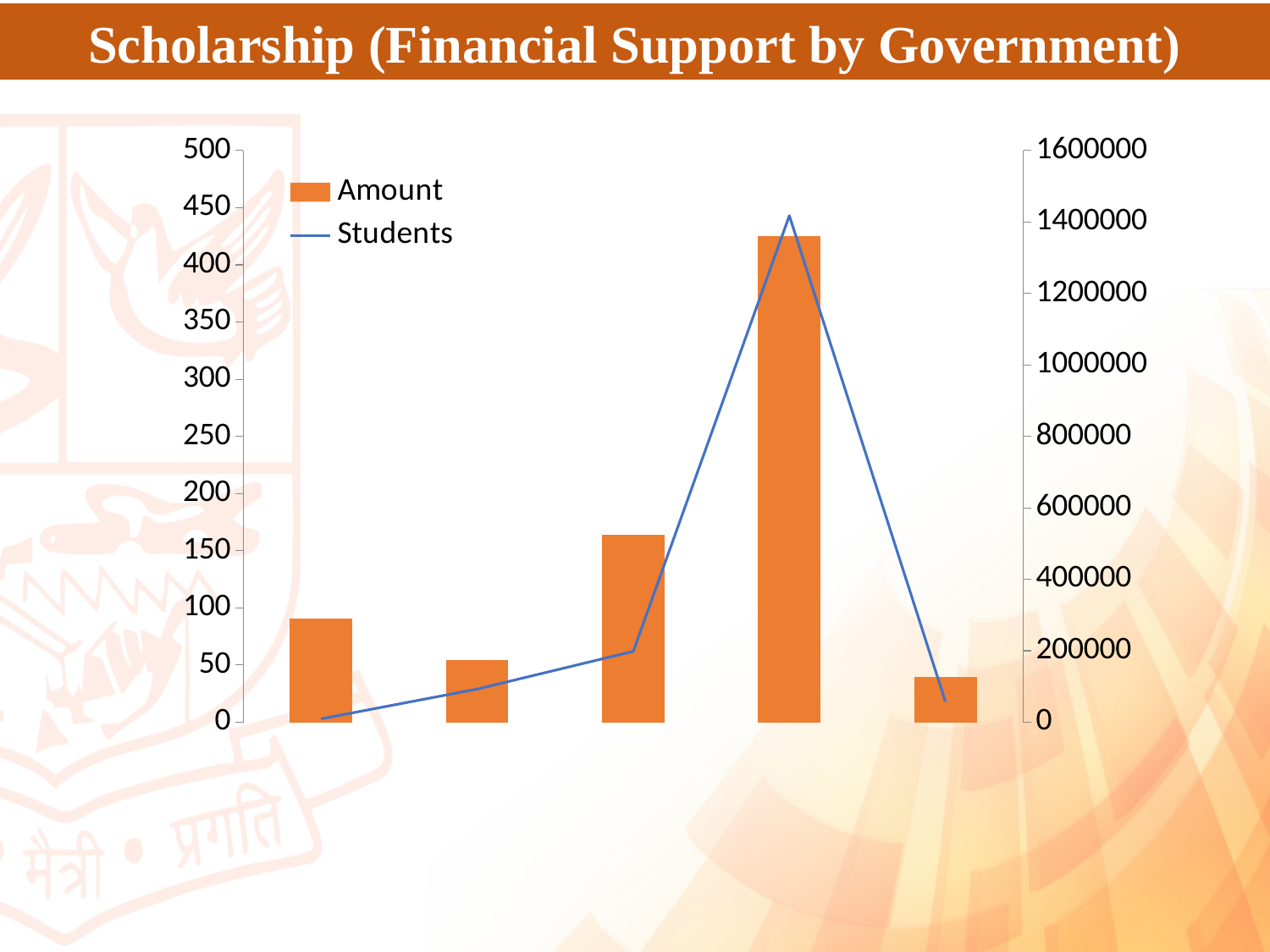
Which bar (by position from left) has the highest Amount value? The fourth bar Which bar (by position from left) has the lowest Amount value? The fifth bar What are the two series named in the legend? Amount and Students Is the Amount value for the third bar from the left greater or less than 150? greater Is the Amount value for the fourth bar from the left greater or less than 400? greater Which is larger, the Amount value for the first bar or the second bar from the left? The first bar How many series does the legend list? 2 What kind of chart is shown on the slide? A combination bar and line chart How many bars are plotted for the Amount series? 5